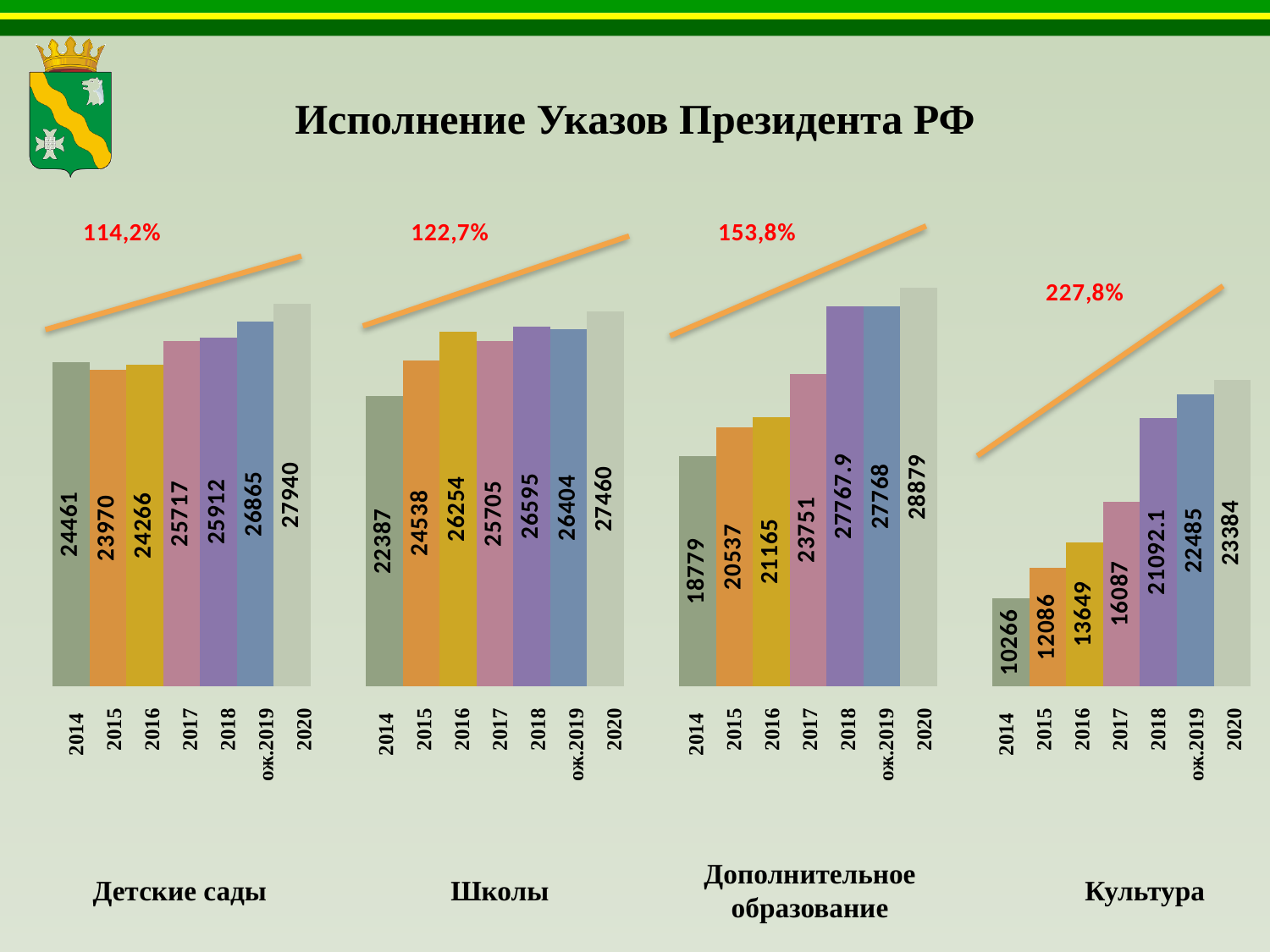
In the "Культура" chart, do the values rise or fall from 2014 to 2020? Rise In the "Культура" chart, which year has the highest value? 2020 What type of chart is used for "Школы"? Bar chart In the "Дополнительное образование" chart, what is the value for 2018? 27767.9 In the "Школы" chart, what is the difference between the 2020 value and the 2014 value? 5073 What percentage is printed in red above the "Дополнительное образование" chart? 153,8% In the "Школы" chart, what is the value for ож.2019? 26404 In the "Детские сады" chart, which year has the lowest value? 2015 How many bars are plotted in the "Культура" chart? 7 In the "Детские сады" chart, what is the value for 2017? 25717 In the "Культура" chart, what is the value for 2014? 10266 In the "Дополнительное образование" chart, which is larger: the value for 2017 or the value for 2016? 2017